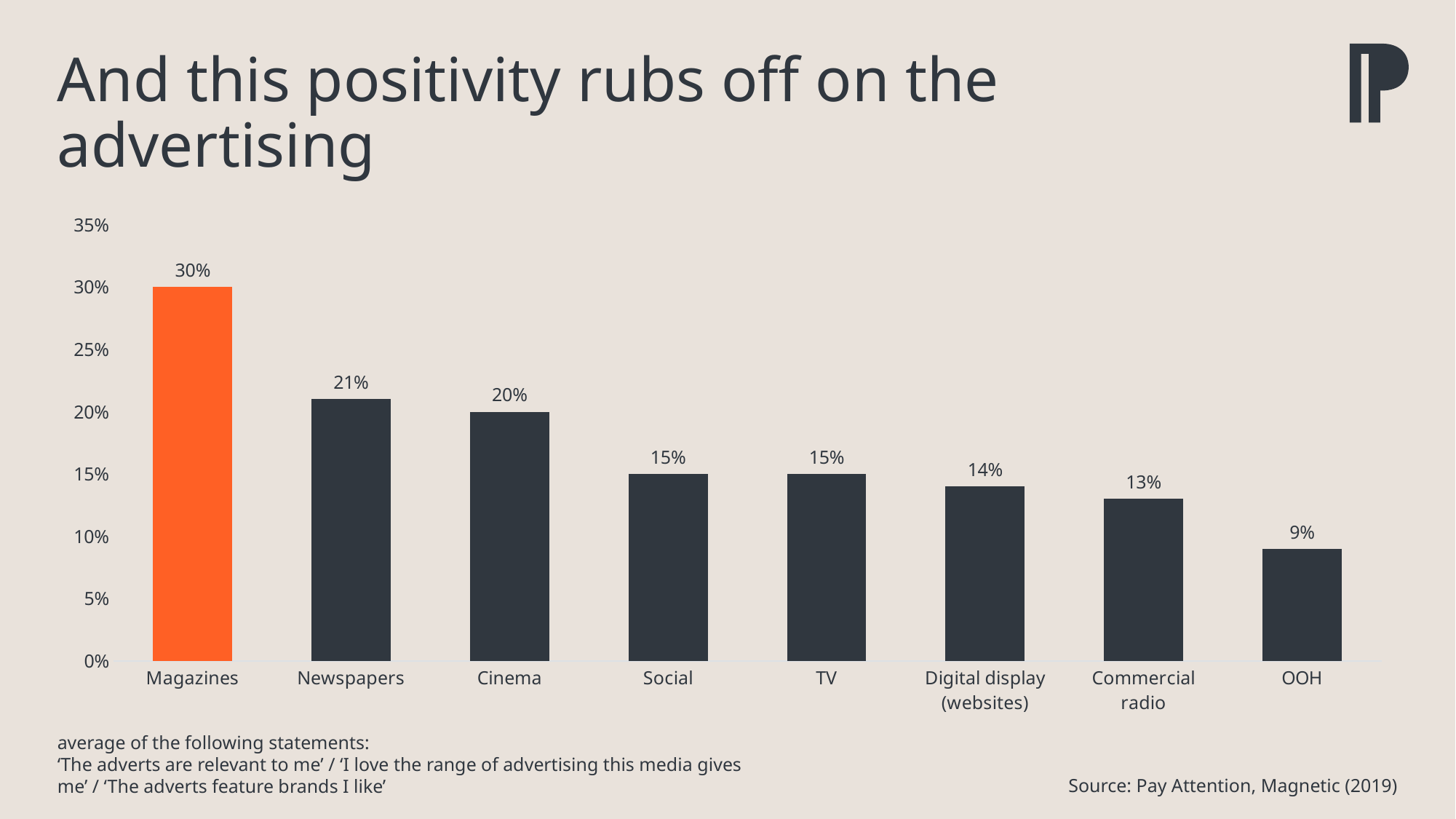
What is the value for Magazines? 30% Which category has the lowest value? OOH What is the value for Commercial radio? 13% What is the difference between the values for Magazines and Newspapers? 9% How many categories are shown on the x axis? 8 Which bar is highlighted in orange? Magazines Is the value for Cinema greater or less than 15%? greater Which category has the highest value? Magazines Which is larger, the value for Newspapers or the value for Social? Newspapers What is the value for Digital display (websites)? 14% What kind of chart is shown on the slide? Bar chart What is the difference between the values for Cinema and OOH? 11%